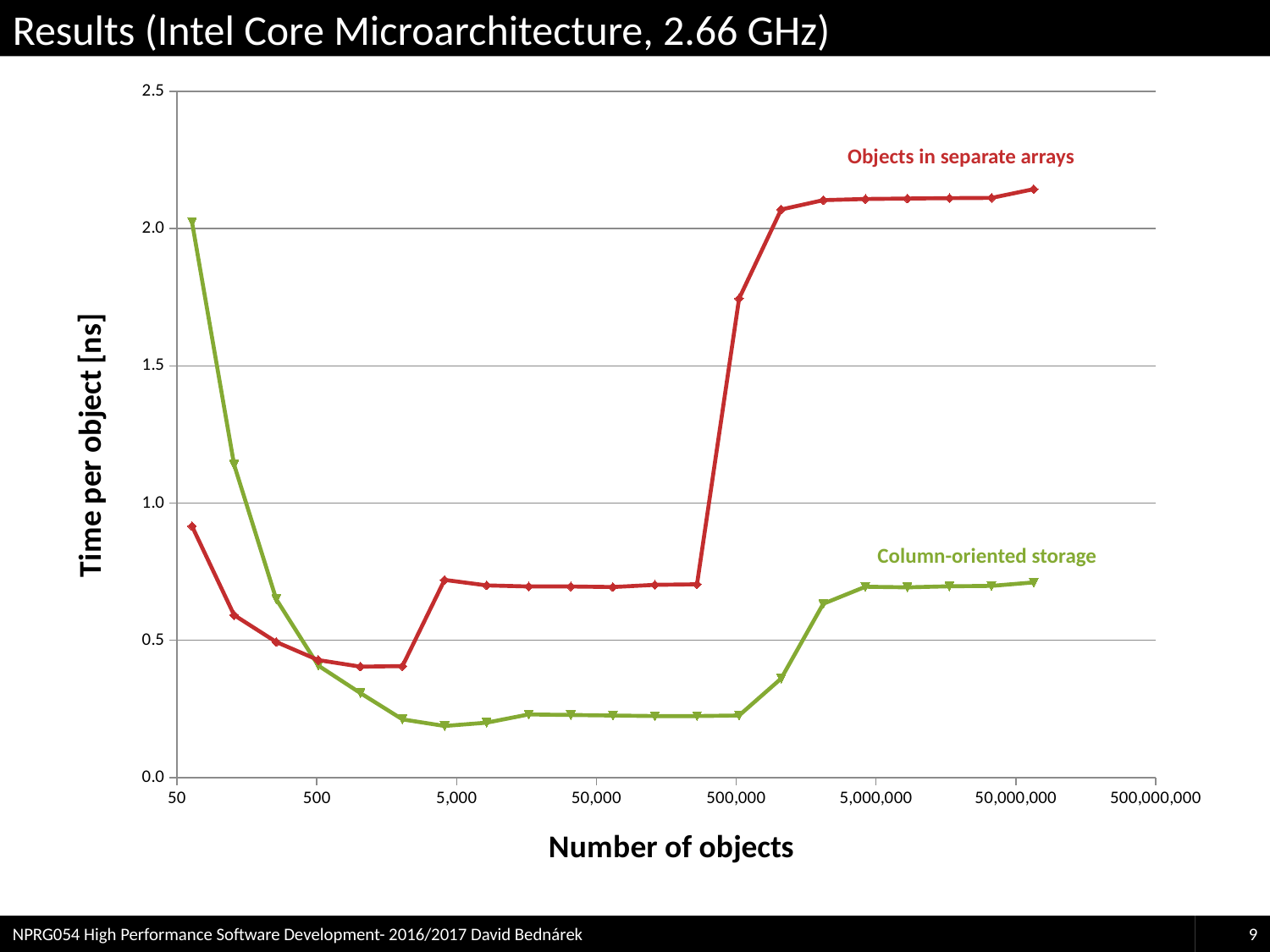
Is the value for Objects in separate arrays at 50,000,000 objects greater or less than 2.0? greater Is the value for Objects in separate arrays at 50,000 objects greater or less than 1.0? less What kind of chart is shown on the slide? line chart Does the Objects in separate arrays line rise or fall between 500,000 and 5,000,000 objects? rise What is the title of the horizontal axis? Number of objects Is the value for Column-oriented storage at 50,000 objects greater or less than 0.5? less Does the Column-oriented storage line rise or fall between 50 and 500 objects? fall At 50,000,000 objects, which series has the higher time per object? Objects in separate arrays At 50 objects, which series has the higher time per object? Column-oriented storage What is the title of the vertical axis? Time per object [ns] How many data series are plotted on the chart? 2